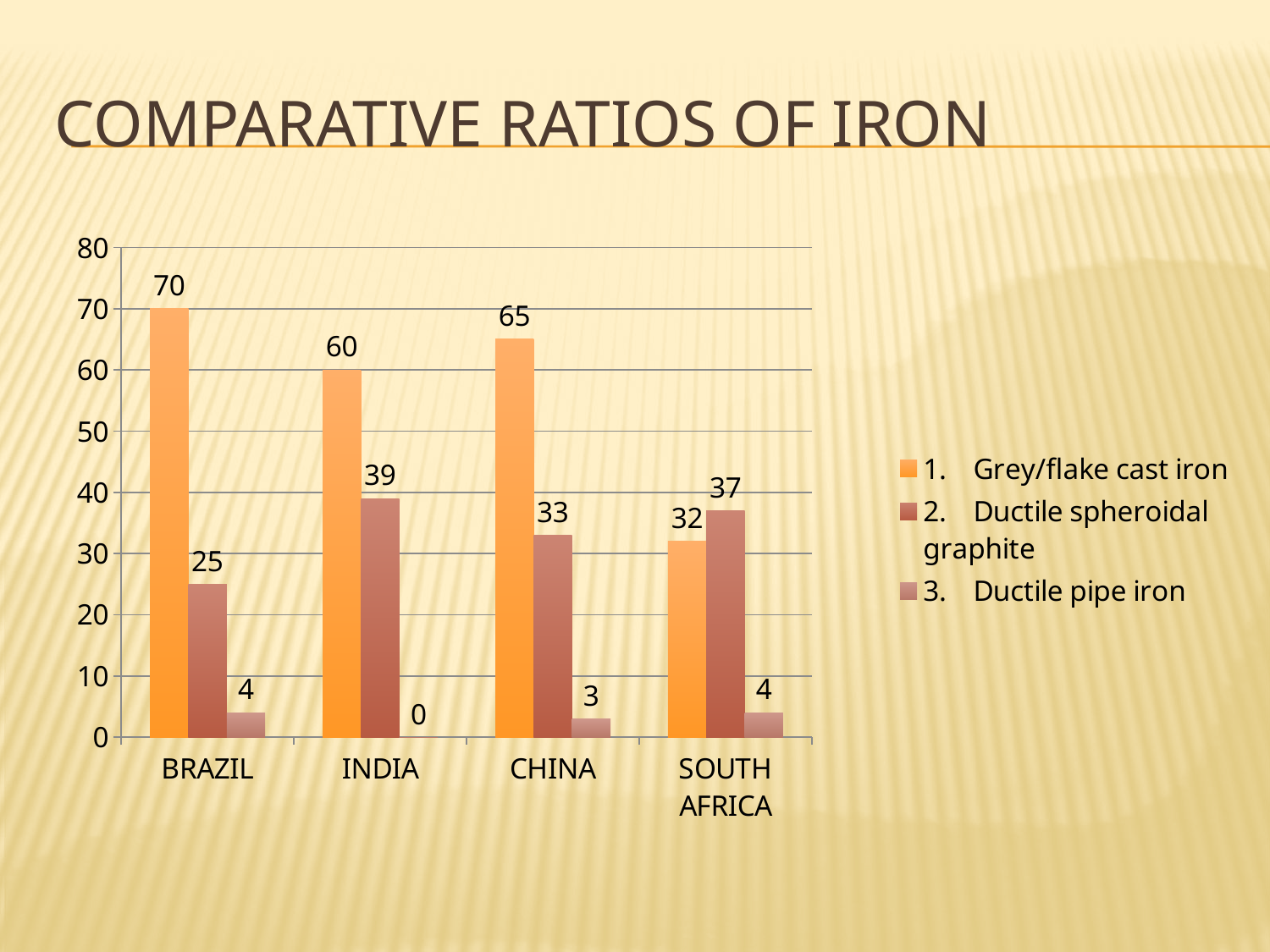
What is the value for Grey/flake cast iron in Brazil? 70 Which is larger in South Africa: Grey/flake cast iron or Ductile spheroidal graphite? Ductile spheroidal graphite What is the difference between the Grey/flake cast iron values for Brazil and South Africa? 38 What is the title of the slide? COMPARATIVE RATIOS OF IRON What is the value for Ductile spheroidal graphite in India? 39 Which country has the highest value for Grey/flake cast iron? Brazil What is the value for Ductile spheroidal graphite in China? 33 How many countries are shown on the x axis? 4 Which country has the lowest value for Ductile pipe iron? India What kind of chart is shown on the slide? Bar chart How many series does the legend list? 3 What is the value for Ductile pipe iron in China? 3